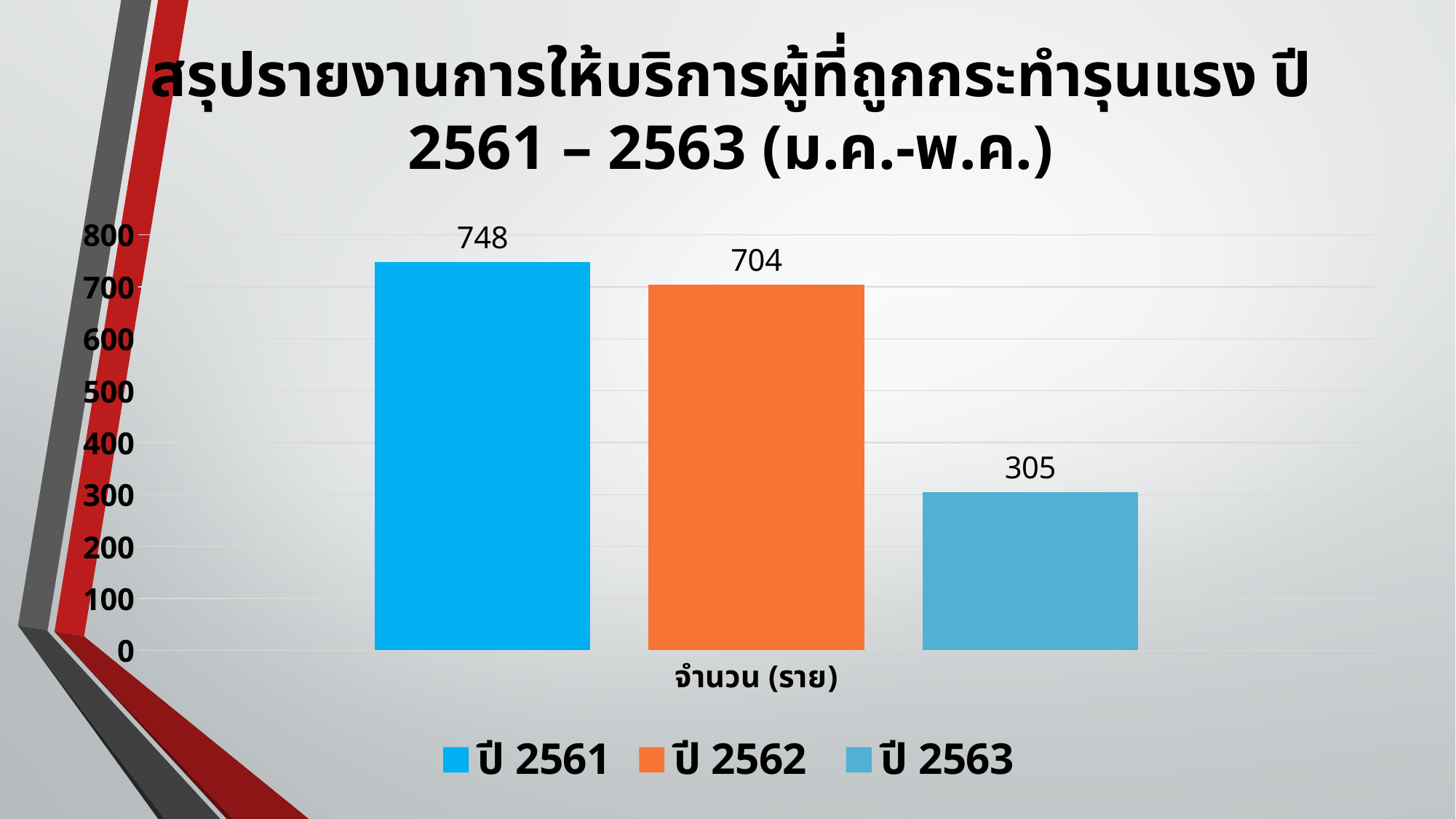
What is the label on the x axis of the chart? จำนวน (ราย) How many series does the legend list? 3 What is the difference between the values for ปี 2561 and ปี 2562? 44 Is the value for ปี 2563 greater or less than 400? less What is the difference between the values for ปี 2562 and ปี 2563? 399 Which series has the lowest value? ปี 2563 Which series has the highest value? ปี 2561 What is the value for ปี 2563? 305 What is the value for ปี 2561? 748 Which is larger, the value for ปี 2561 or ปี 2563? ปี 2561 What is the value for ปี 2562? 704 What kind of chart is shown on the slide? bar chart